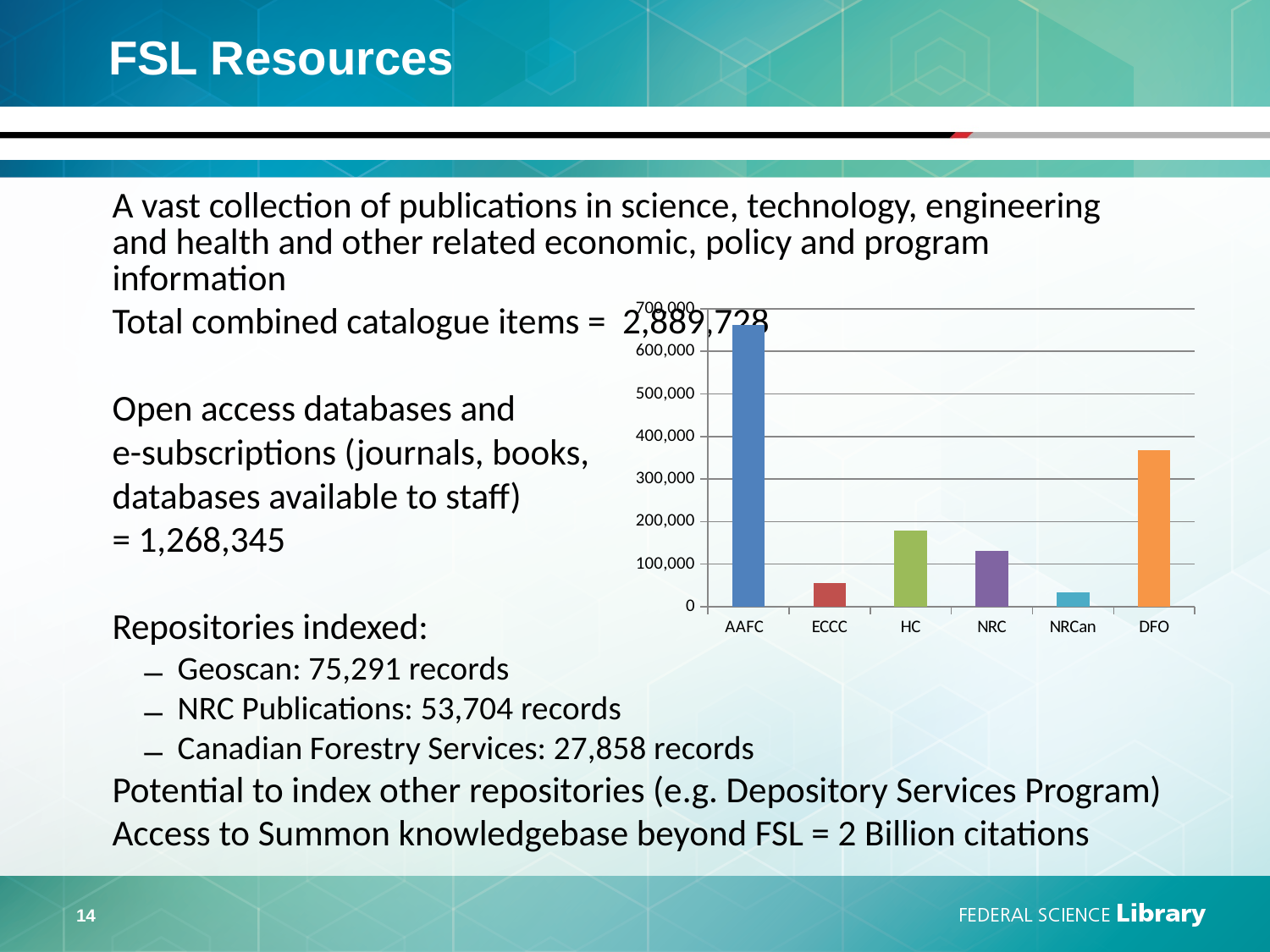
Is the value for NRC greater or less than 200,000? less How many categories are shown on the x axis of the chart? 6 Which is larger in the chart, the value for DFO or the value for HC? DFO Which is larger in the chart, the value for ECCC or the value for NRCan? ECCC Which category has the highest bar in the chart? AAFC Is the value for AAFC greater or less than 600,000? greater Which is larger in the chart, the value for HC or the value for NRC? HC What kind of chart is shown on the slide? bar chart What is the highest value shown on the y axis of the chart? 700,000 Is the value for DFO greater or less than 300,000? greater Which category has the lowest bar in the chart? NRCan